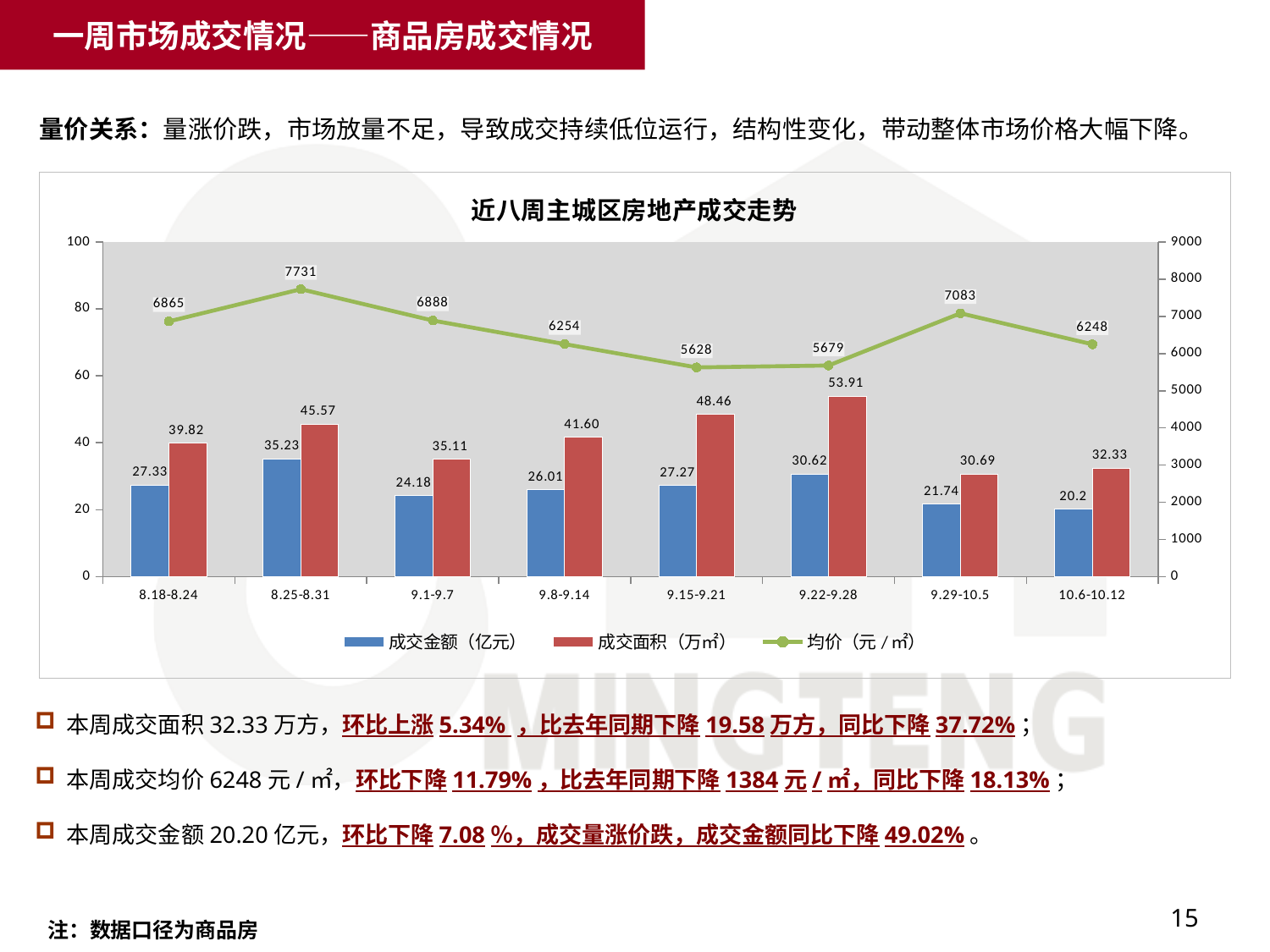
Which week has the highest 均价（元/㎡）? 8.25-8.31 What is the difference in 成交面积（万㎡） between the weeks 9.22-9.28 and 9.29-10.5? 23.22 How many series does the legend of the chart list? 3 What is the 成交金额（亿元） value for the week 10.6-10.12? 20.2 Which week has the lowest 均价（元/㎡）? 9.15-9.21 Which week has the lowest 成交金额（亿元）? 10.6-10.12 Which is larger, the 成交金额（亿元） for 8.25-8.31 or for 9.22-9.28? 8.25-8.31 What is the title of the chart? 近八周主城区房地产成交走势 What type of chart is shown on the slide? Combined bar and line chart How many weekly periods are shown on the x axis of the chart? 8 What is the 成交面积（万㎡） value for the week 9.22-9.28? 53.91 What is the 均价（元/㎡） value for the week 8.25-8.31? 7731